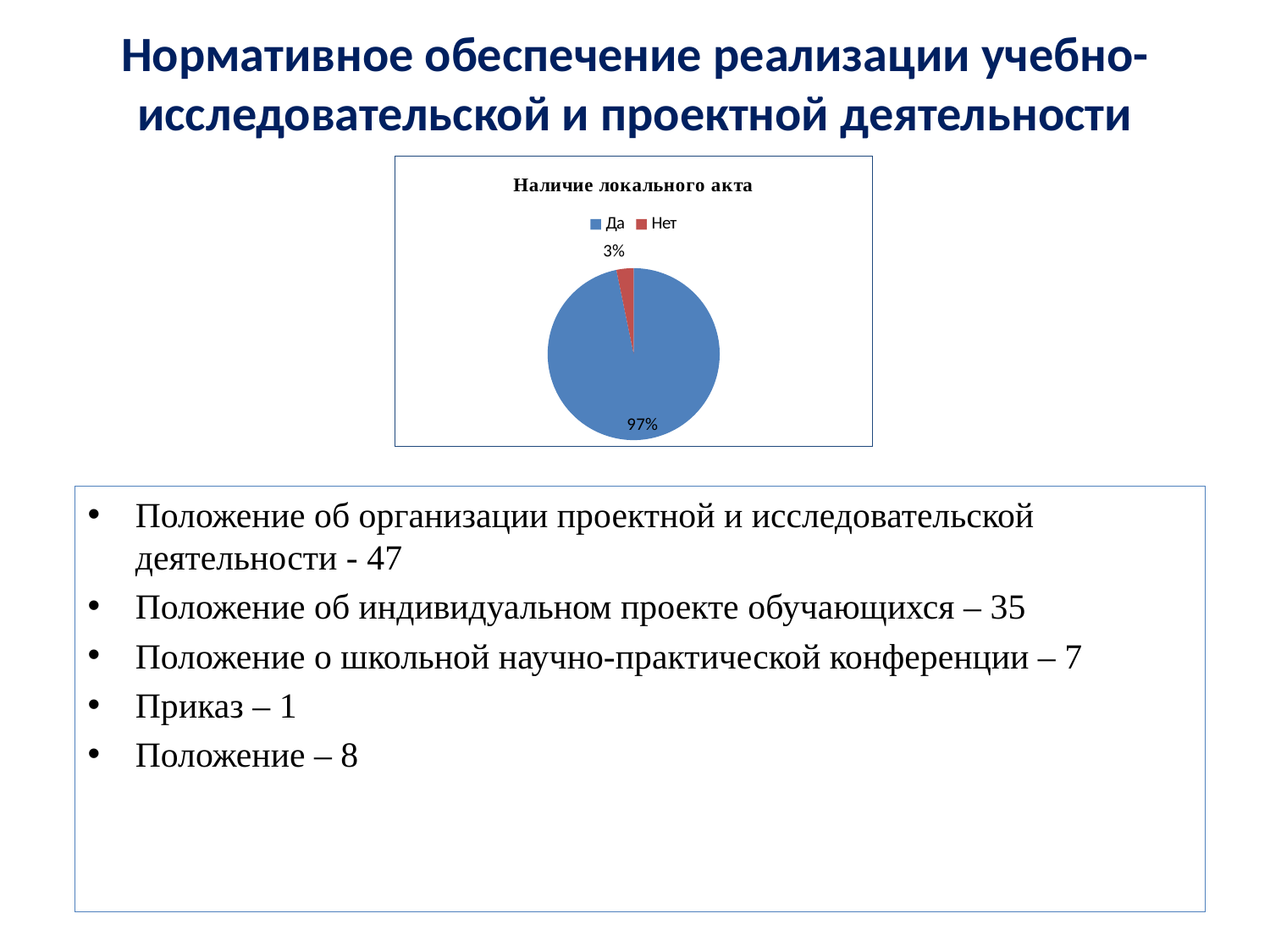
Which category has the largest slice of the pie? Да What kind of chart is shown on the slide? pie chart What is the difference in percentage points between the "Да" and "Нет" slices? 94 What colour is the "Нет" slice? red What share of the pie does the "Да" slice represent? 97% Which slice is larger, "Да" or "Нет"? Да How many slices does the pie chart have? 2 What is the title of the chart? Наличие локального акта How many categories does the legend list? 2 What share of the pie does the "Нет" slice represent? 3% Which category has the smallest slice of the pie? Нет